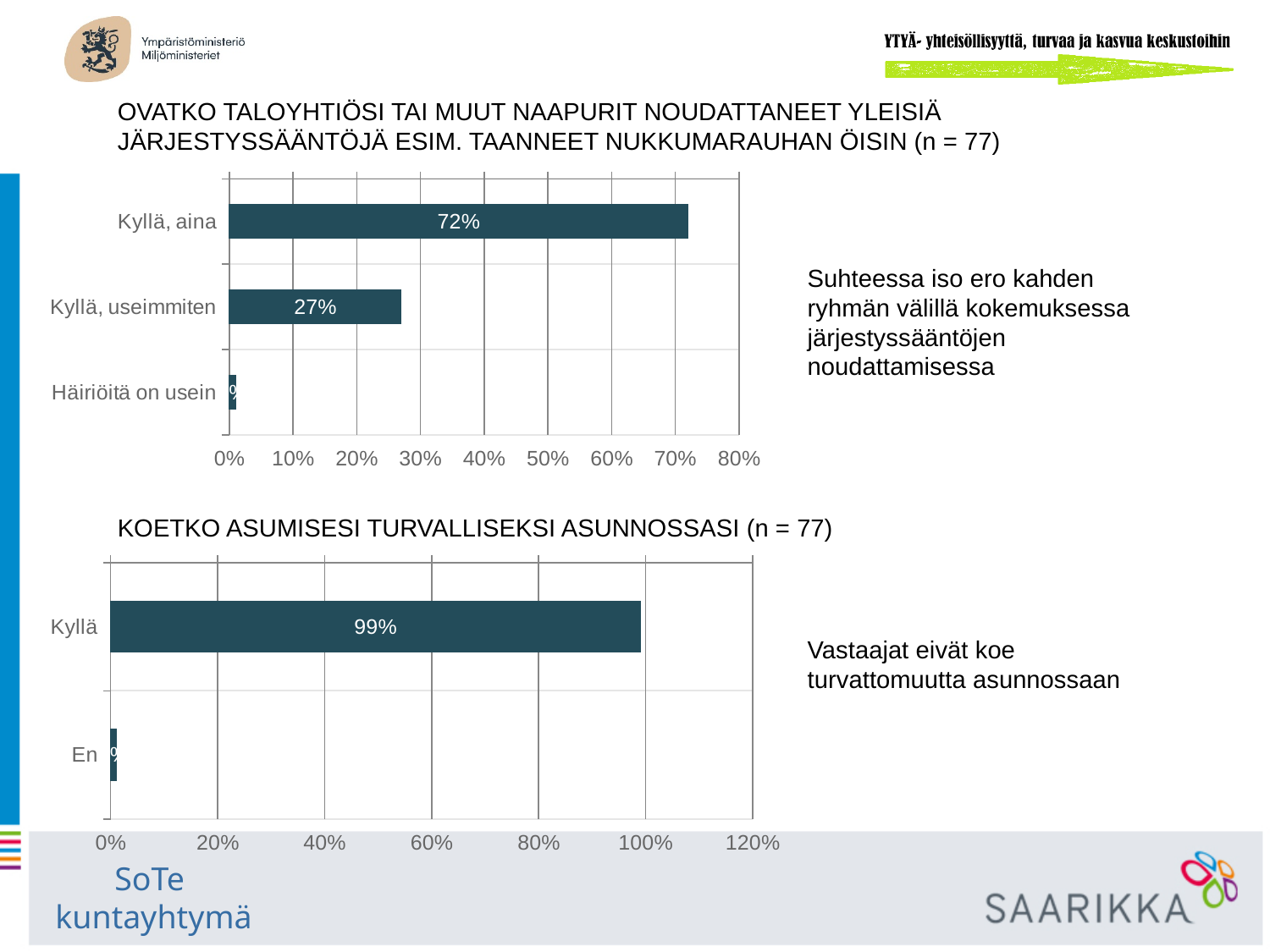
In the bottom chart (KOETKO ASUMISESI TURVALLISEKSI ASUNNOSSASI), is the value for "En" greater or less than 20%? less In the bottom chart (KOETKO ASUMISESI TURVALLISEKSI ASUNNOSSASI), which is larger, "Kyllä" or "En"? Kyllä In the top chart (OVATKO TALOYHTIÖSI TAI MUUT NAAPURIT NOUDATTANEET...), what is the value for "Kyllä, useimmiten"? 27% In the top chart (OVATKO TALOYHTIÖSI TAI MUUT NAAPURIT NOUDATTANEET...), what is the difference in percentage points between "Kyllä, aina" and "Kyllä, useimmiten"? 45 percentage points In the bottom chart (KOETKO ASUMISESI TURVALLISEKSI ASUNNOSSASI), what is the value for "Kyllä"? 99% What kind of chart is the top chart (OVATKO TALOYHTIÖSI TAI MUUT NAAPURIT NOUDATTANEET...)? Bar chart In the bottom chart (KOETKO ASUMISESI TURVALLISEKSI ASUNNOSSASI), what is the highest value shown on the x axis? 120% In the top chart (OVATKO TALOYHTIÖSI TAI MUUT NAAPURIT NOUDATTANEET...), which category has the lowest value? Häiriöitä on usein In the top chart (OVATKO TALOYHTIÖSI TAI MUUT NAAPURIT NOUDATTANEET...), what is the value for "Kyllä, aina"? 72% In the top chart (OVATKO TALOYHTIÖSI TAI MUUT NAAPURIT NOUDATTANEET...), which category has the highest value? Kyllä, aina In the top chart (OVATKO TALOYHTIÖSI TAI MUUT NAAPURIT NOUDATTANEET...), is the value for "Häiriöitä on usein" greater or less than 10%? less In the top chart (OVATKO TALOYHTIÖSI TAI MUUT NAAPURIT NOUDATTANEET...), how many categories are shown? 3